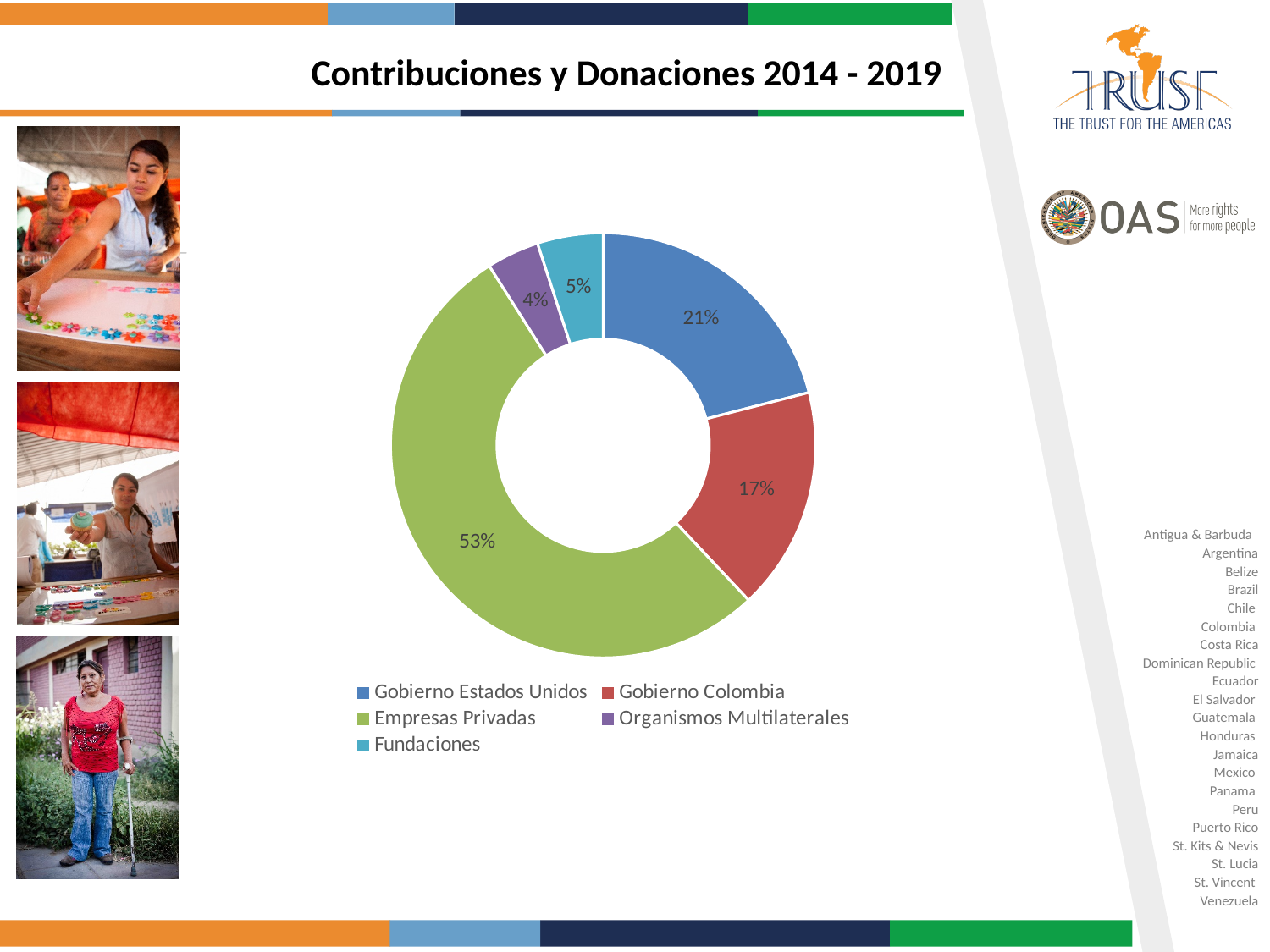
What is the value shown for Fundaciones? 5% What share of the donut chart does Empresas Privadas represent? 53% What is the value shown for Gobierno Colombia? 17% What is the value shown for Gobierno Estados Unidos? 21% What kind of chart is shown on the slide? Donut (pie) chart What is the difference in percentage points between Gobierno Estados Unidos and Gobierno Colombia? 4 What is the title of the slide containing the chart? Contribuciones y Donaciones 2014 - 2019 Which category has the largest share of the chart? Empresas Privadas How many categories does the chart show? 5 Which is larger, the share for Gobierno Estados Unidos or the share for Gobierno Colombia? Gobierno Estados Unidos Which category has the smallest share of the chart? Organismos Multilaterales What is the value shown for Organismos Multilaterales? 4%